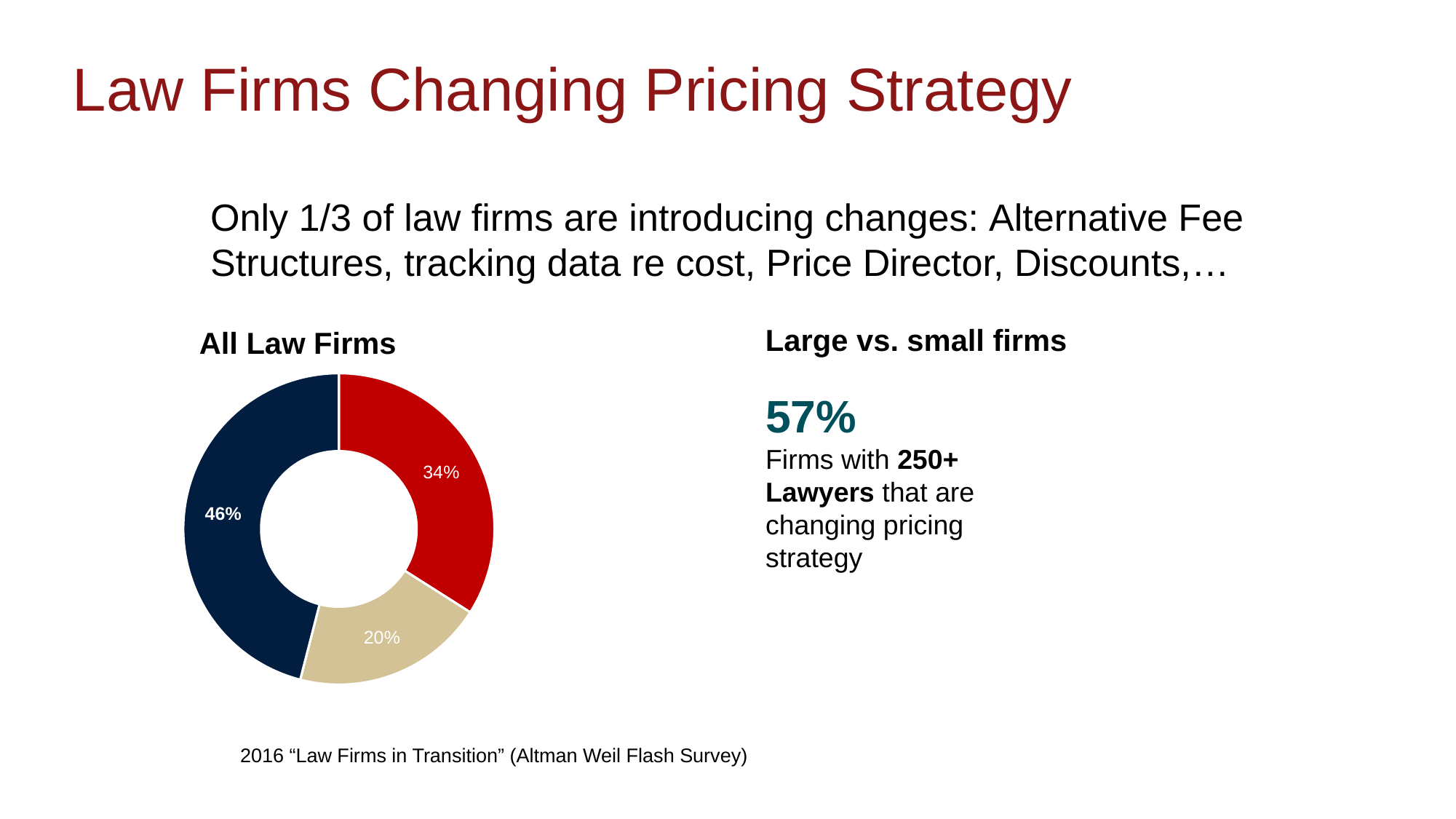
What kind of chart is shown under the heading "All Law Firms"? doughnut chart What value is shown on the dark blue slice of the "All Law Firms" chart? 46% In the "All Law Firms" chart, which is larger, the red slice or the tan slice? the red slice What is the title shown above the doughnut chart? All Law Firms In the "All Law Firms" chart, what is the difference between the red slice and the tan slice? 14 percentage points What colour is the largest slice of the "All Law Firms" chart? dark blue How many slices does the "All Law Firms" chart have? 3 Which slice of the "All Law Firms" chart has the largest value? the dark blue slice (46%) What value is shown on the tan slice of the "All Law Firms" chart? 20% What value is shown on the red slice of the "All Law Firms" chart? 34% Which slice of the "All Law Firms" chart has the smallest value? the tan slice (20%) In the "All Law Firms" chart, what is the difference between the dark blue slice and the red slice? 12 percentage points